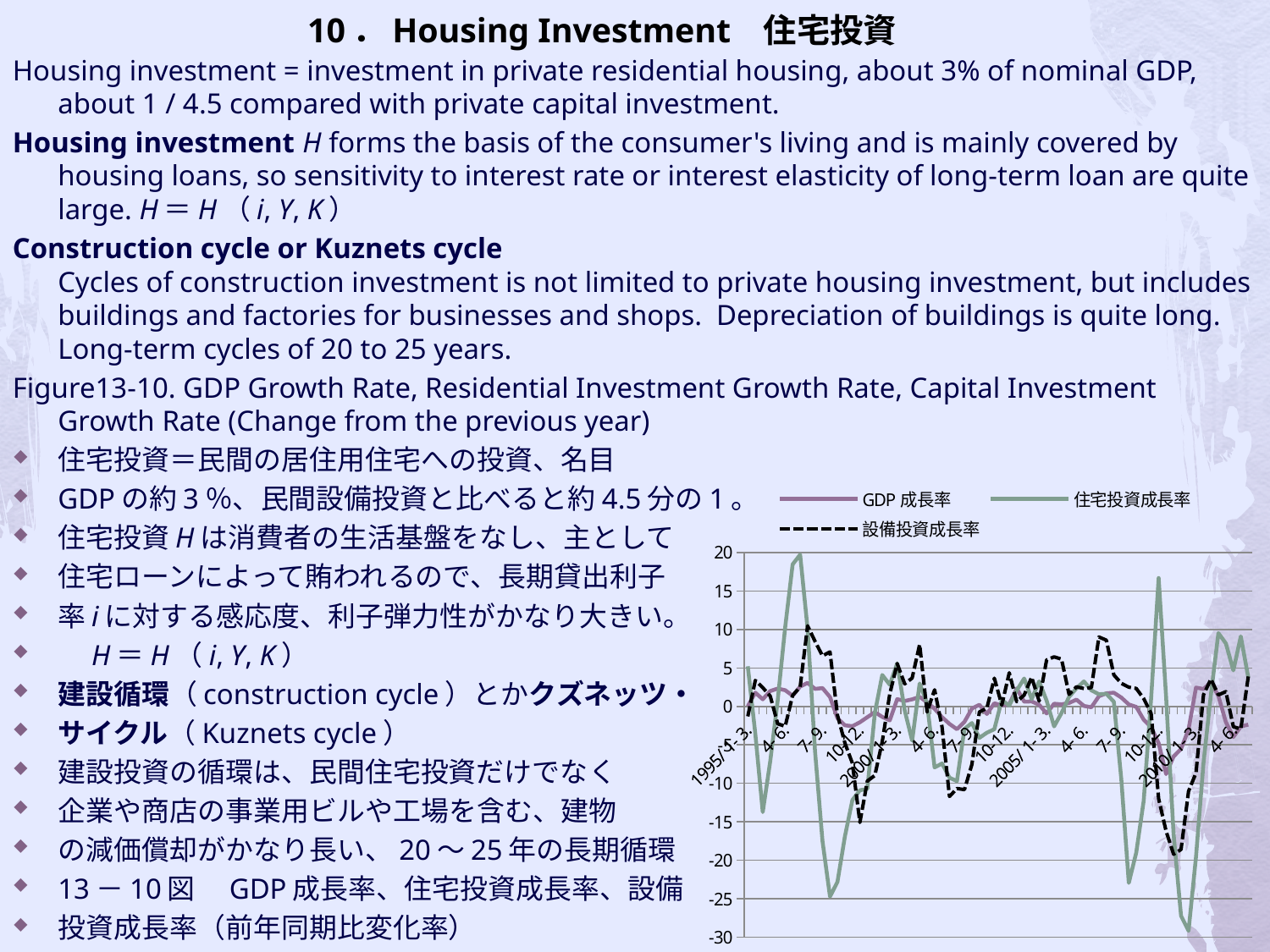
Is the lowest value of 住宅投資成長率 on the chart greater or less than -25? less What is the lowest value shown on the chart's vertical axis? -30 What is the first label on the chart's horizontal axis? 1995/ 1- 3. Is the lowest value of 設備投資成長率 on the chart greater or less than -15? less Is the highest value of GDP 成長率 on the chart greater or less than 10? less Which series reaches the lowest value on the chart? 住宅投資成長率 What kind of chart is shown on the slide? line chart Which series is drawn with a dashed line in the chart? 設備投資成長率 How many series does the chart's legend list? 3 Which series reaches the highest peak on the chart? 住宅投資成長率